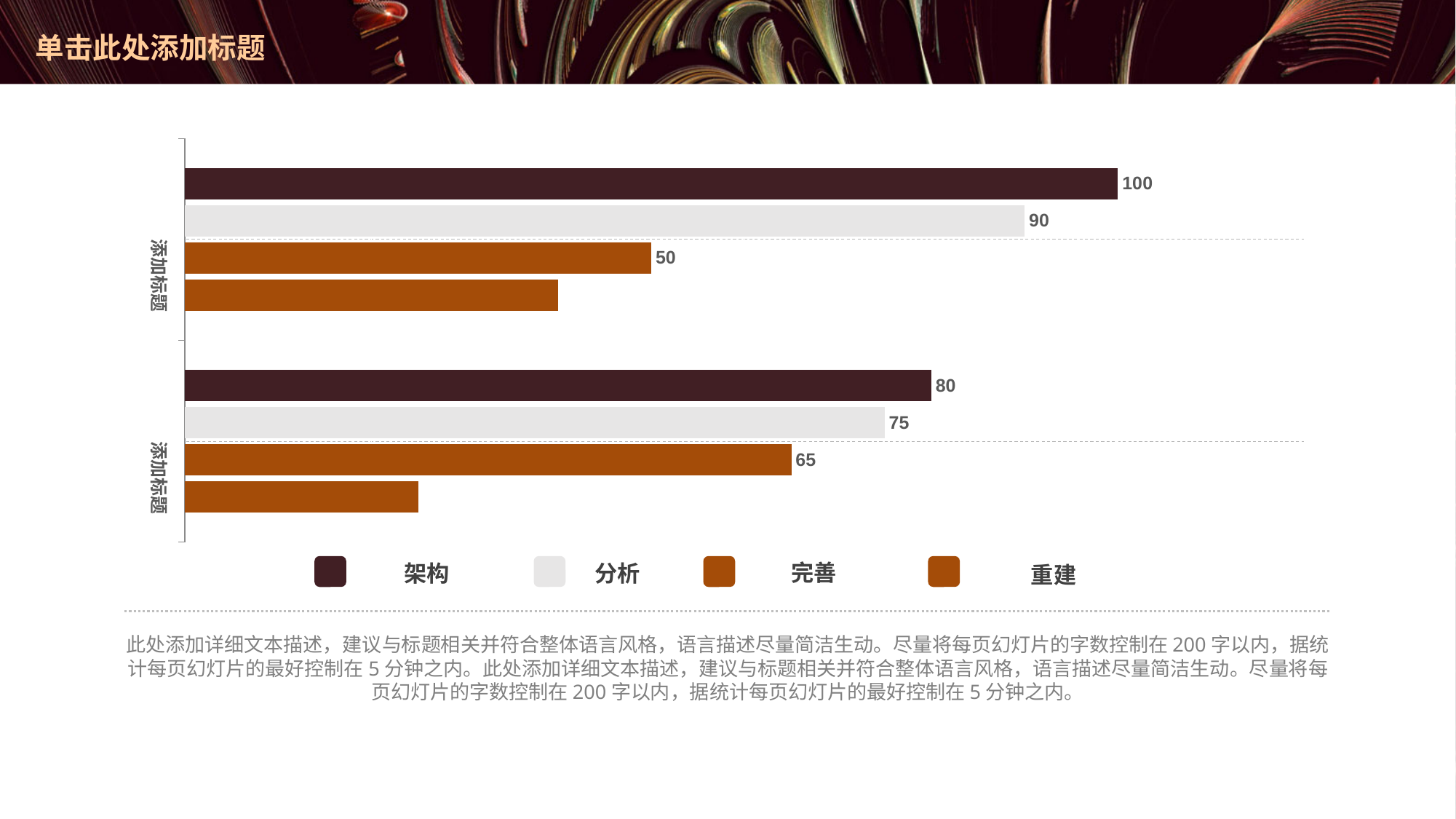
Which is larger: the 分析 value in the top group or the 架构 value in the bottom group? 分析 in the top group What is the value of the 架构 bar in the bottom category group? 80 How many series does the chart legend list? 4 What is the value of the 架构 bar in the top category group? 100 How many category groups are plotted on the chart? 2 What is the value of the 完善 bar in the top category group? 50 What is the difference between the 架构 and 分析 values in the top category group? 10 What is the value of the 分析 bar in the bottom category group? 75 Which series has the highest value in the top category group? 架构 Which series has the lowest value in the bottom category group? 重建 What are the four series names listed in the legend? 架构, 分析, 完善, 重建 What kind of chart is shown on the slide? bar chart